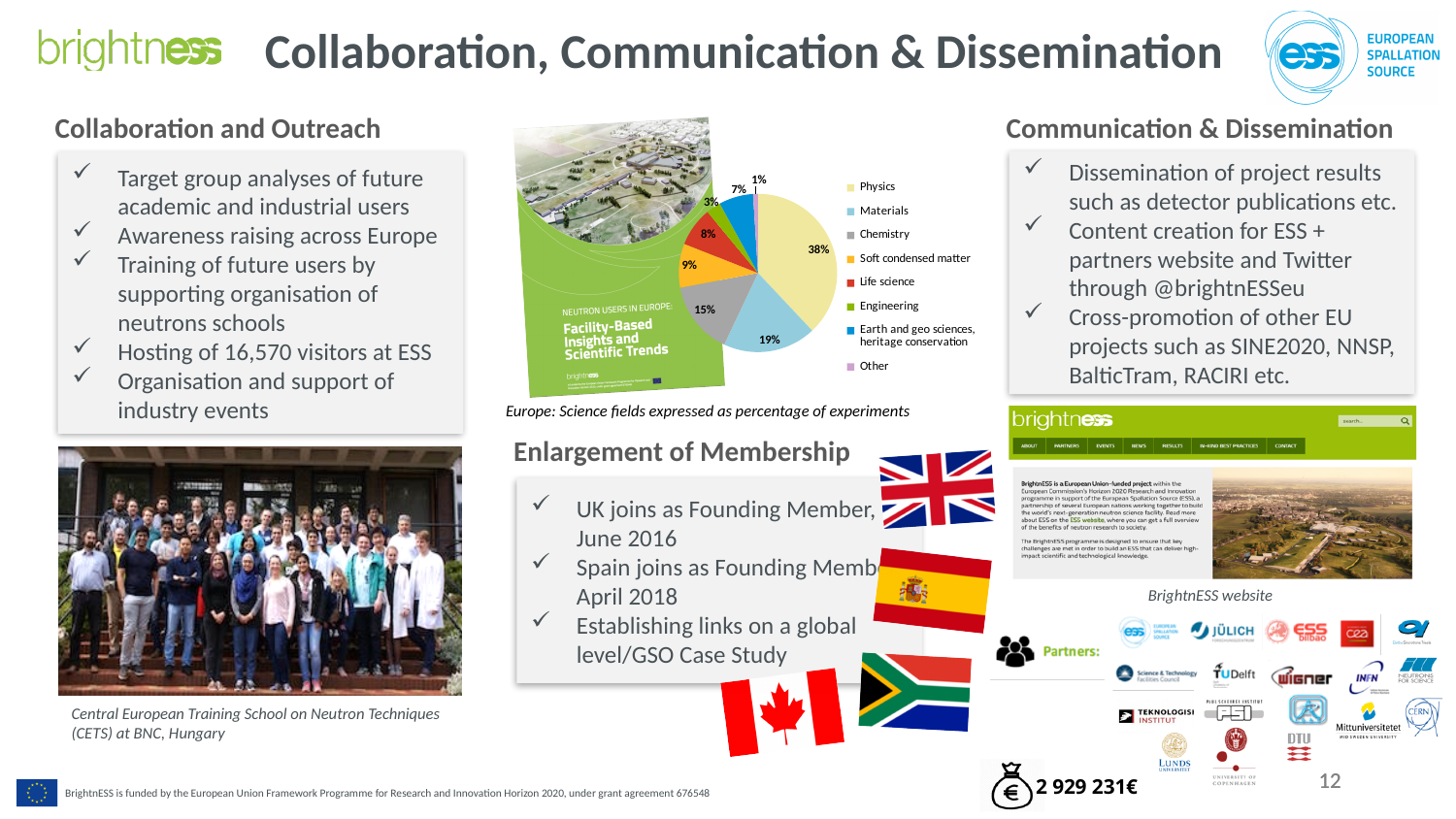
What kind of chart is shown in the centre of the slide, captioned 'Europe: Science fields expressed as percentage of experiments'? pie chart Which science field has the largest share in the pie chart? Physics In the pie chart, which has a larger share: Chemistry or Soft condensed matter? Chemistry What is the caption below the pie chart? Europe: Science fields expressed as percentage of experiments In the pie chart, what percentage of experiments is attributed to Materials? 19% In the pie chart, what percentage of experiments is attributed to Chemistry? 15% In the pie chart, what percentage of experiments is attributed to Life science? 8% In the pie chart, what percentage of experiments is attributed to Other? 1% In the pie chart, how many percentage points larger is the Physics share than the Materials share? 19 In the pie chart, what percentage of experiments is attributed to Physics? 38% How many science fields are listed in the pie chart's legend? 8 Which science field has the smallest share in the pie chart? Other